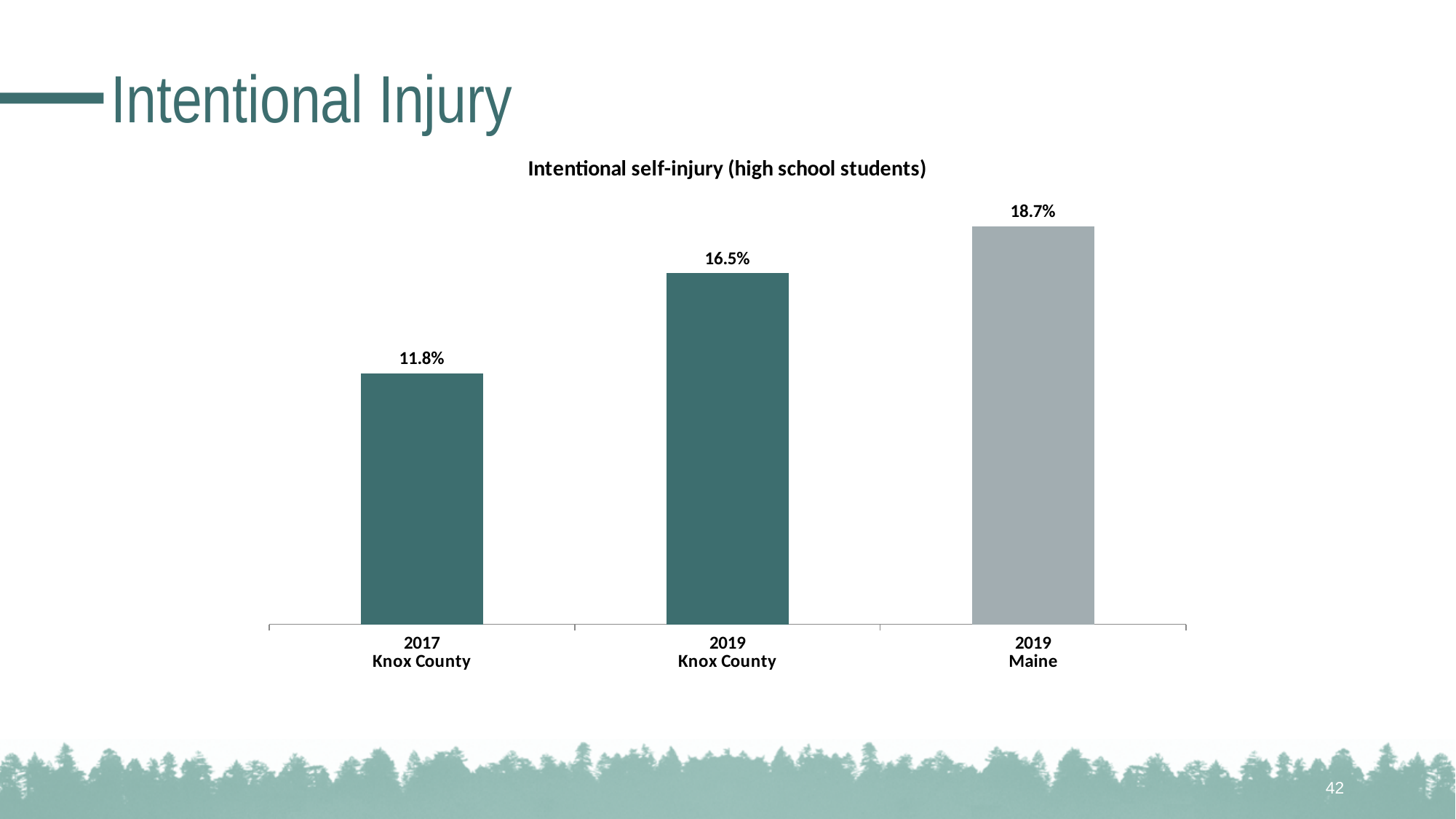
What is the title of the chart? Intentional self-injury (high school students) What is the difference between the 2019 Knox County value and the 2017 Knox County value? 4.7% Which category has the lowest value? 2017 Knox County What is the value for 2019 Knox County? 16.5% Which is larger, the value for 2019 Knox County or the value for 2019 Maine? 2019 Maine Do the values rise or fall from left to right across the chart? Rise What is the difference between the 2019 Maine value and the 2019 Knox County value? 2.2% What is the value for 2017 Knox County? 11.8% How many bars are shown in the chart? 3 Which category has the highest value? 2019 Maine What kind of chart is shown on the slide? Bar chart What is the value for 2019 Maine? 18.7%